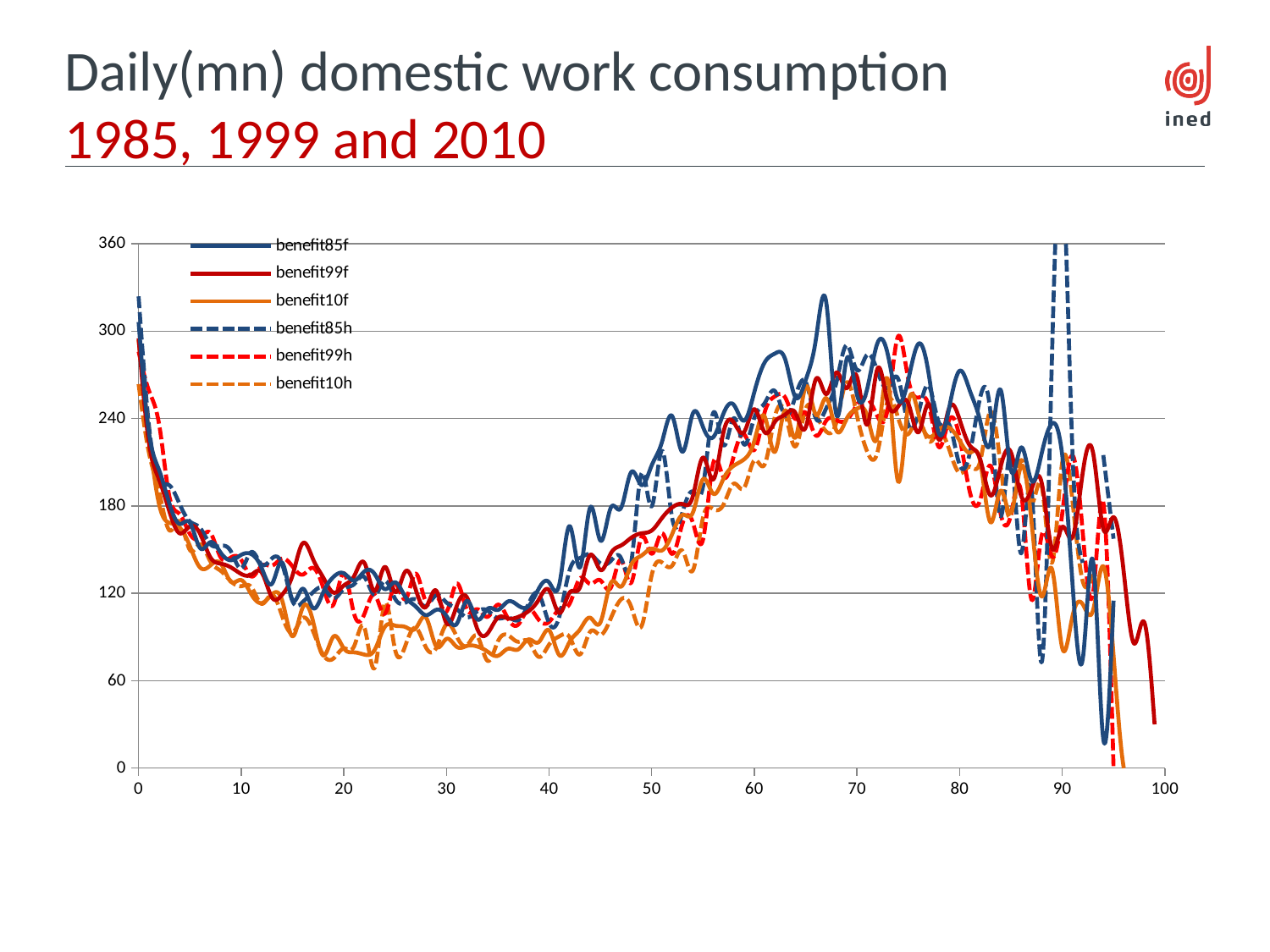
How many series does the legend list? 6 Is the value of benefit10h at x = 30 greater or less than 120? less What is the highest value shown on the vertical axis? 360 Is the value of benefit85h at x = 90 greater or less than 300? greater Around x = 20, which series is lower: benefit10f or benefit85f? benefit10f Is the value of benefit99f at x = 60 greater or less than 180? greater Which legend entries are drawn with dashed lines? benefit85h, benefit99h, benefit10h Do the series generally rise or fall between x = 40 and x = 70? rise What kind of chart is shown on the slide? line chart Do the series generally rise or fall between x = 0 and x = 20? fall